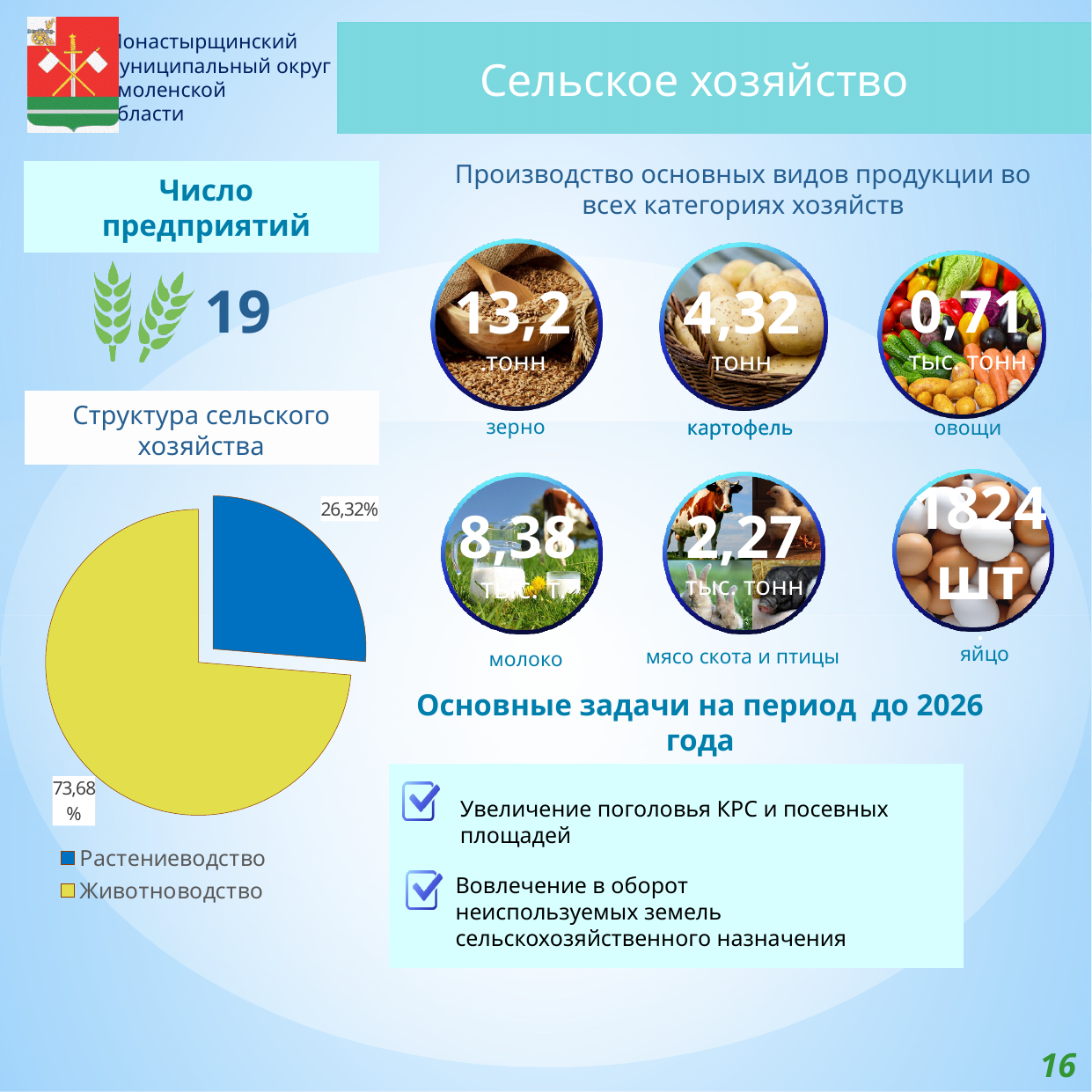
What is the share of the yellow slice in the pie chart? 73,68% By how many percentage points does Животноводство exceed Растениеводство in the pie chart? 47,36% What colour is the Растениеводство slice in the pie chart? Blue What is the title of the chart on the slide? Структура сельского хозяйства Which category has the largest slice in the pie chart? Животноводство What share of the pie chart does Животноводство account for? 73,68% Which category has the smallest slice in the pie chart? Растениеводство What kind of chart is shown under the heading 'Структура сельского хозяйства'? Pie chart How many slices does the pie chart have? 2 How many entries does the legend of the pie chart list? 2 What share of the pie chart does Растениеводство account for? 26,32% Which is larger in the pie chart, Растениеводство or Животноводство? Животноводство